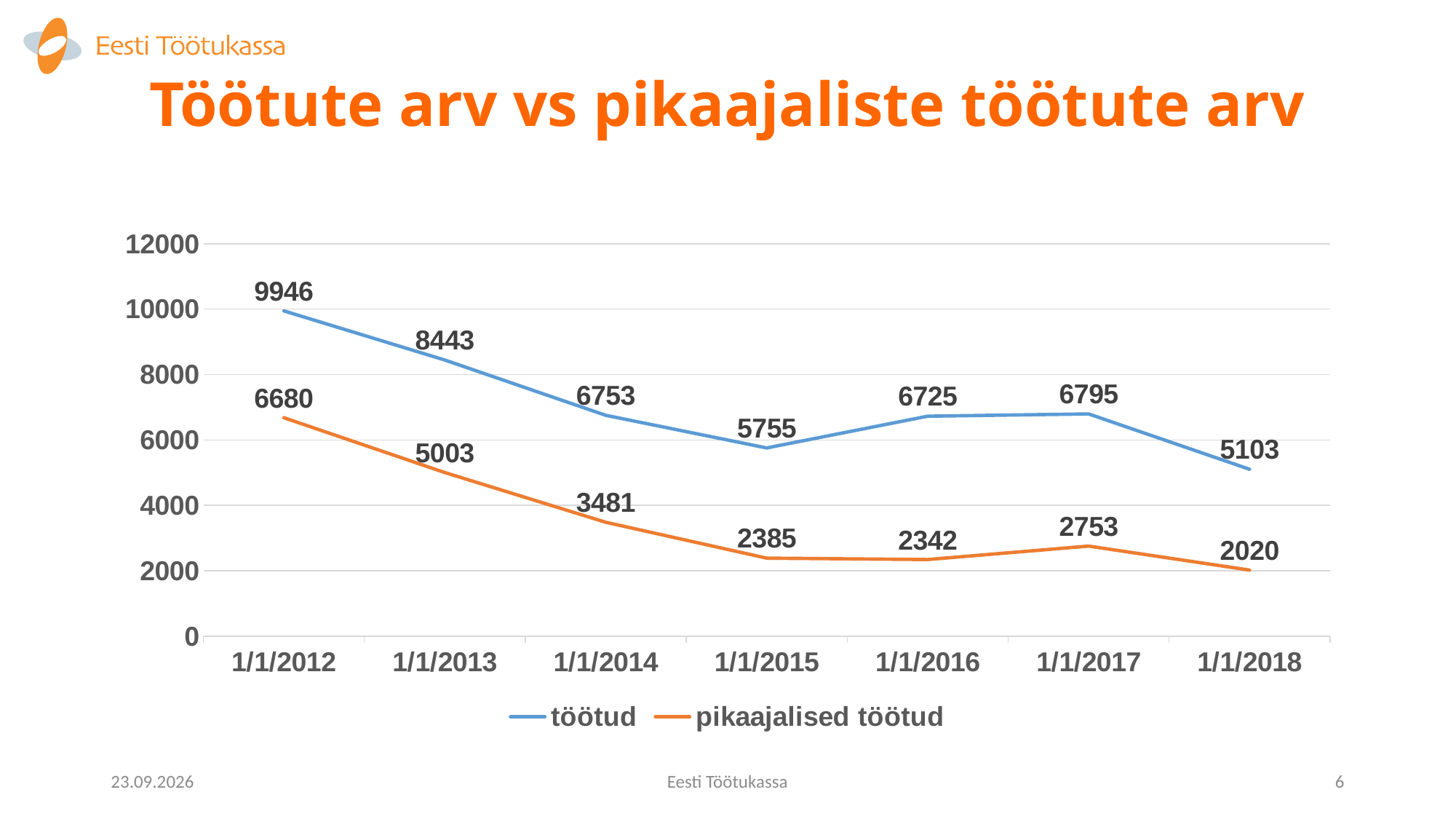
What kind of chart is shown on the slide? line chart How many dates are shown on the x axis? 7 What is the value of the töötud series at 1/1/2012? 9946 At which date is the pikaajalised töötud series lowest? 1/1/2018 Is the pikaajalised töötud value at 1/1/2013 greater or less than 4000? greater What is the value of the pikaajalised töötud series at 1/1/2015? 2385 Does the pikaajalised töötud series rise or fall from 1/1/2012 to 1/1/2015? fall How many series does the legend list? 2 What is the difference between the töötud and pikaajalised töötud values at 1/1/2014? 3272 Which is larger: the töötud value at 1/1/2016 or at 1/1/2017? 1/1/2017 What is the value of the töötud series at 1/1/2018? 5103 At which date is the töötud series highest? 1/1/2012